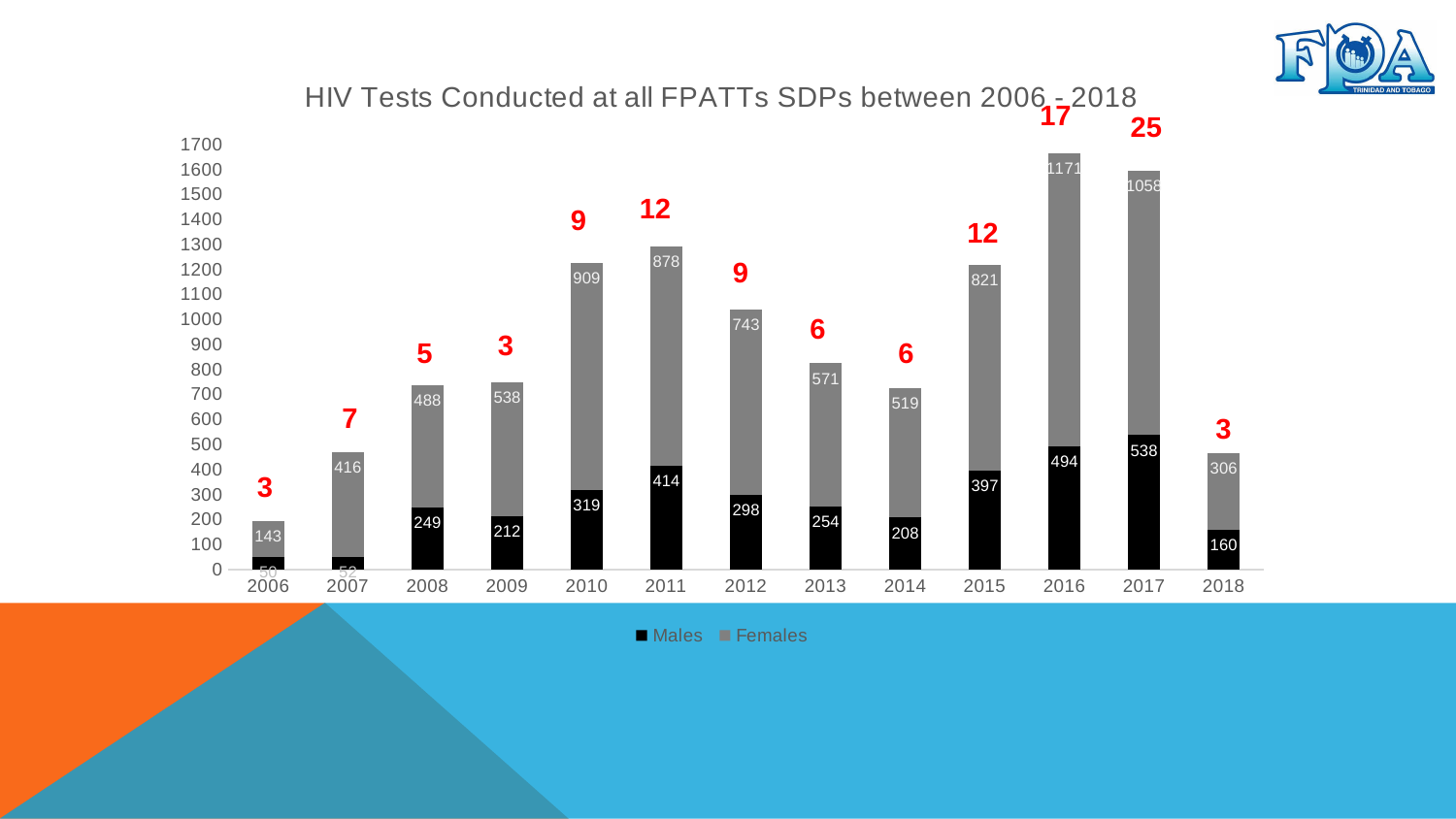
What is the total of the 2018 stacked bar (Males plus Females)? 466 What is the value for Males in 2017? 538 How many years are shown on the x axis? 13 How many HIV tests were conducted on females in 2016? 1171 How many series does the legend list? 2 What kind of chart is shown on the slide? Stacked bar chart Is the total height of the 2016 stacked bar greater or less than 1600? greater In which year was the Females value highest? 2016 What is the title of the chart? HIV Tests Conducted at all FPATTs SDPs between 2006 - 2018 Which is larger, the Males value for 2011 or for 2015? 2011 In which year was the Females value lowest? 2006 What is the difference between the Females values for 2016 and 2017? 113